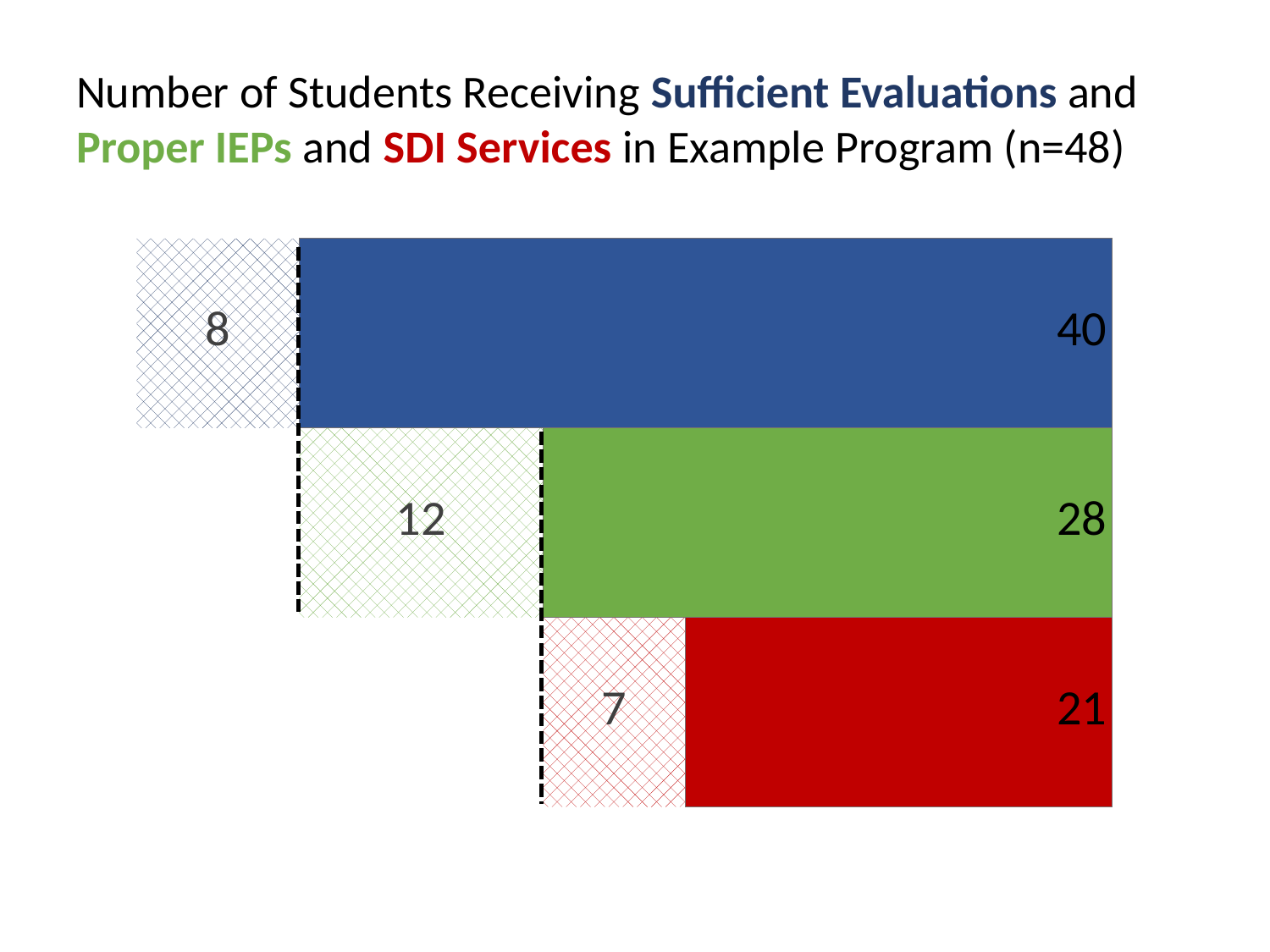
Which solid bar has the highest value: Sufficient Evaluations, Proper IEPs, or SDI Services? Sufficient Evaluations How many students are shown receiving Proper IEPs (the solid green bar)? 28 What is the difference between the number of students receiving Sufficient Evaluations (40) and those receiving SDI Services (21)? 19 What type of chart is shown on the slide? bar chart What value is printed on the hatched segment of the red SDI Services bar? 7 What value is printed on the hatched segment of the green Proper IEPs bar? 12 How many students are shown receiving Sufficient Evaluations (the solid blue bar)? 40 How many bars are plotted in the chart? 3 Which solid bar has the lowest value: Sufficient Evaluations, Proper IEPs, or SDI Services? SDI Services What is the total of the hatched and solid segments of the Sufficient Evaluations bar (8 and 40)? 48 What value is printed on the hatched segment of the blue Sufficient Evaluations bar? 8 How many students are shown receiving SDI Services (the solid red bar)? 21